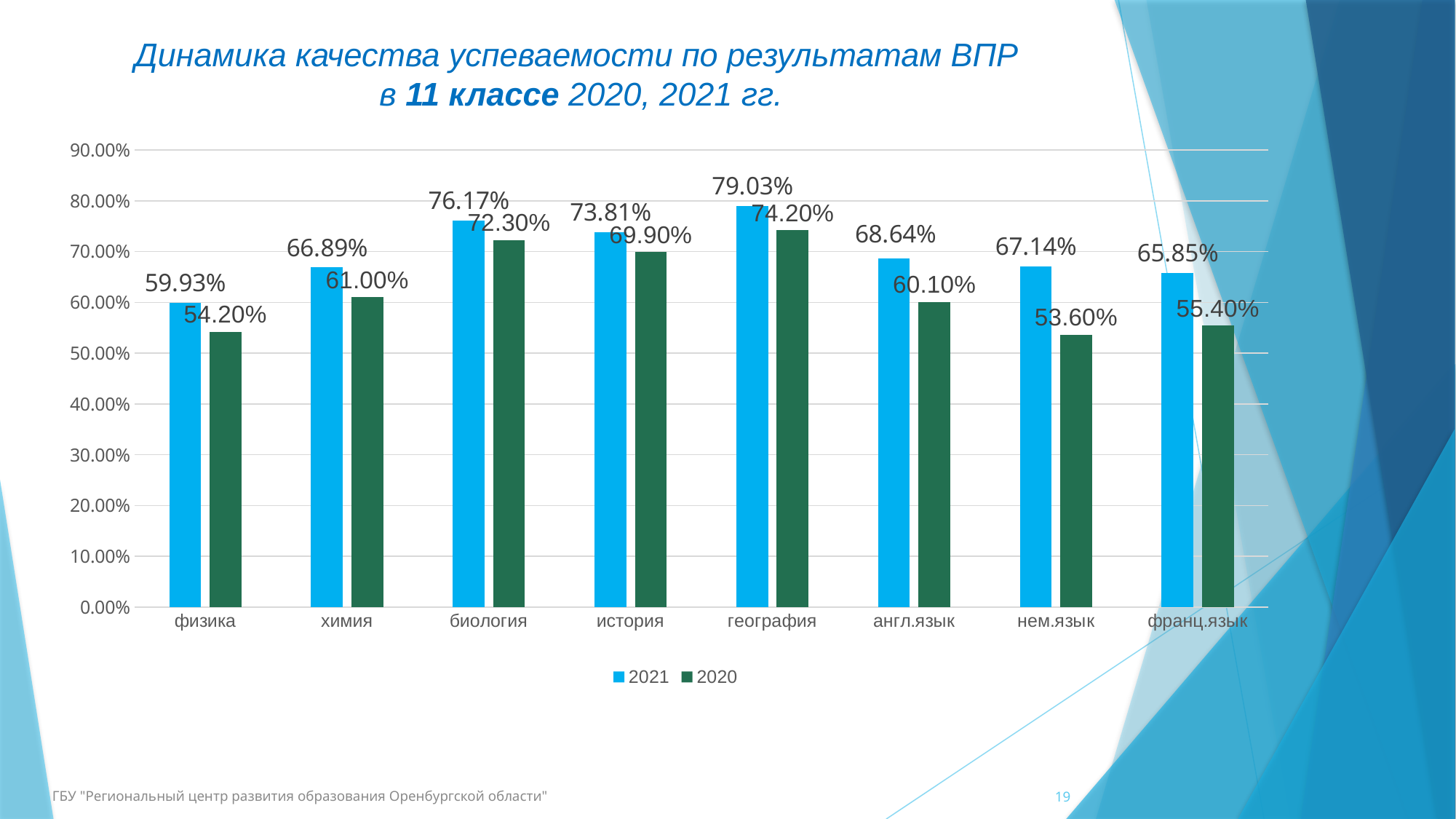
Which subject has the highest 2021 value? география What is the 2020 value for нем.язык? 53.60% Which subject has the lowest 2020 value? нем.язык What is the difference between the 2021 and 2020 values for география? 4.83 percentage points Which subject has the lowest 2021 value? физика What is the difference between the 2021 and 2020 values for нем.язык? 13.54 percentage points What kind of chart is shown on the slide? Bar chart How many series does the legend list? 2 What is the 2021 value for англ.язык? 68.64% How many subjects are shown on the x axis? 8 What is the 2021 value for физика? 59.93% Which is larger for химия: the 2021 value or the 2020 value? 2021